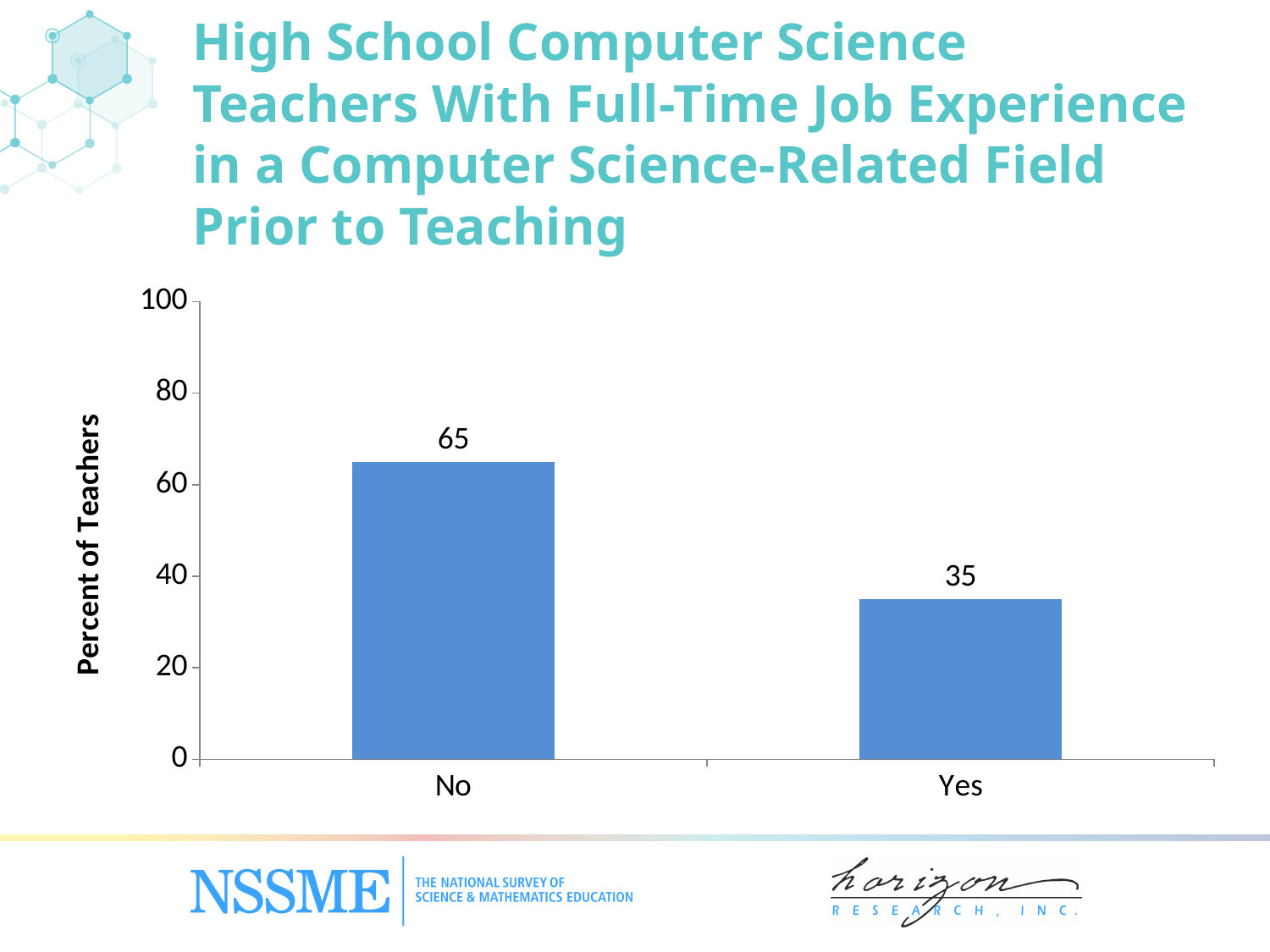
What is the difference in percent of teachers between "No" and "Yes"? 30 Is the value for "Yes" greater or less than 40? less What kind of chart is shown on the slide? bar chart How many categories are shown on the x axis? 2 Which category has the higher percent of teachers? No What is the maximum value shown on the y axis? 100 What percent of teachers answered "No"? 65 What percent of teachers answered "Yes"? 35 Is the value for "Yes" larger or smaller than the value for "No"? smaller Which category has the lower percent of teachers? Yes Is the value for "No" greater or less than 60? greater What is the label of the y axis? Percent of Teachers